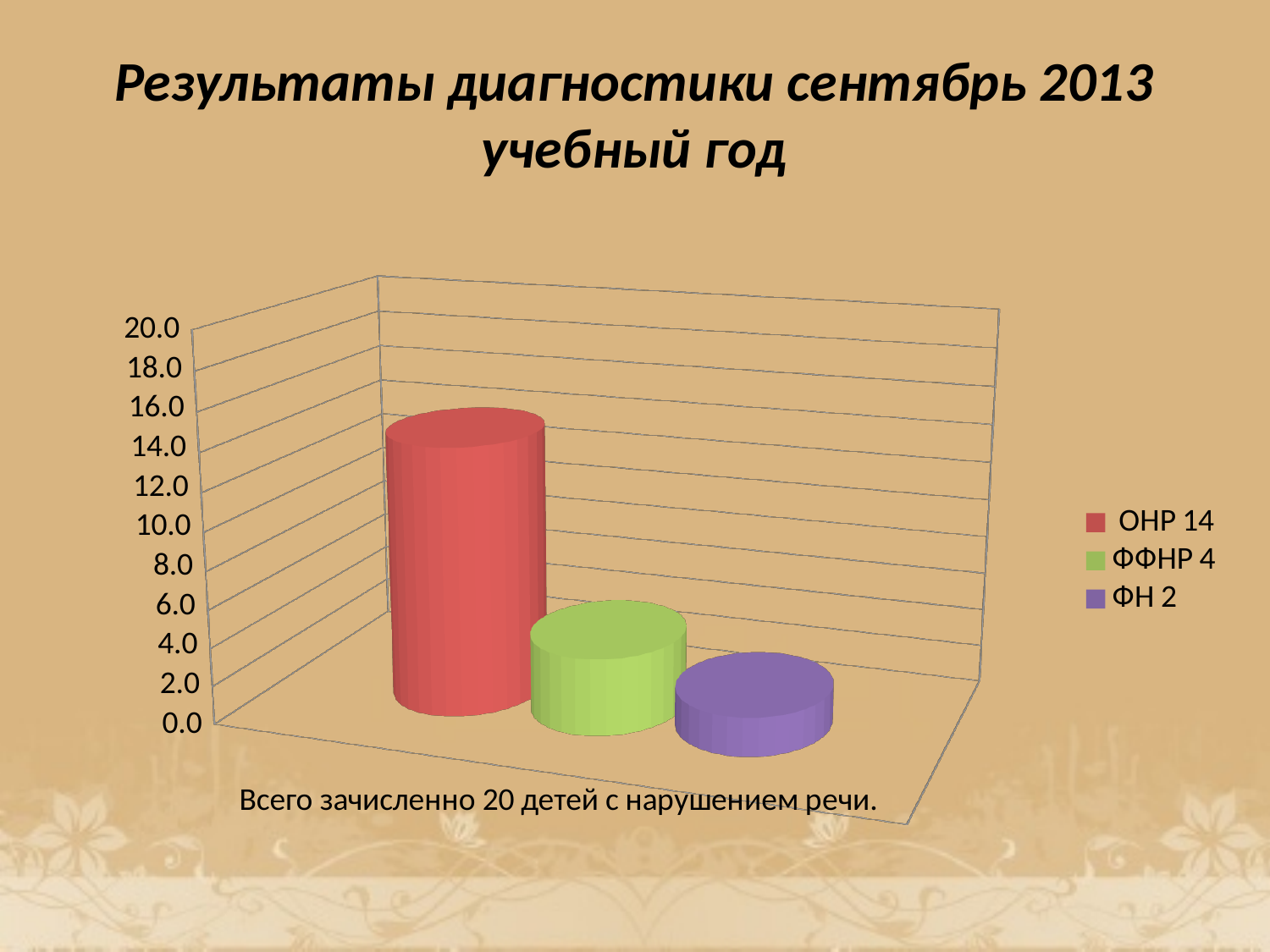
How many bars are plotted in the chart? 3 Which is larger, the bar for ФФНР or the bar for ФН? ФФНР According to the legend, what number is given for ФФНР? 4 What is the difference between the numbers given for ОНР and ФФНР in the legend? 10 According to the legend, what number is given for ОНР? 14 According to the legend, what number is given for ФН? 2 Which legend entry has the tallest bar? ОНР 14 What colour is the bar for ОНР? red Is the value of the ОНР bar greater or less than 10.0? greater What kind of chart is shown on the slide? bar chart Which legend entry has the shortest bar? ФН 2 How many entries does the chart legend list? 3